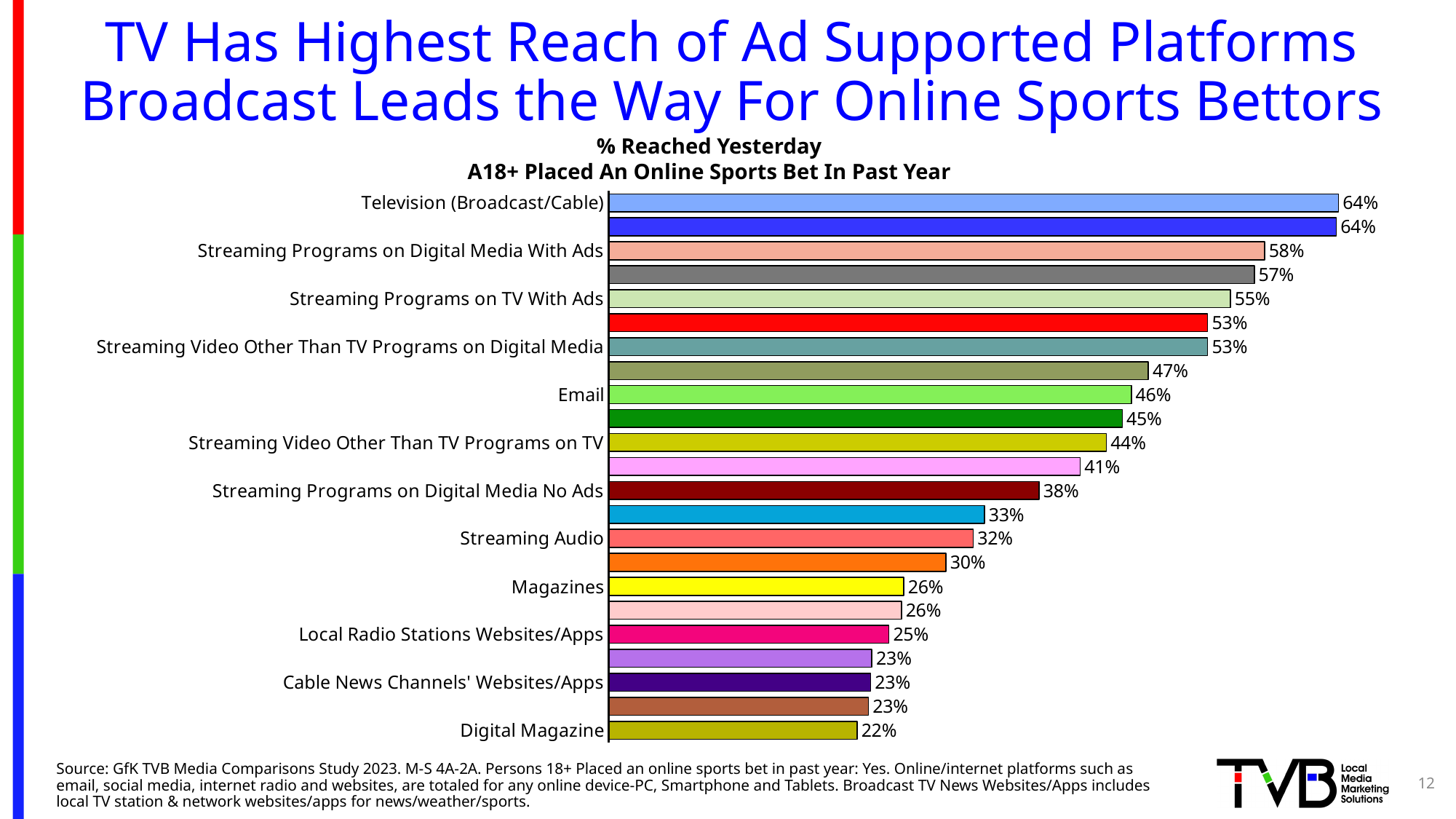
Which is larger, Streaming Video Other Than TV Programs on Digital Media or Streaming Video Other Than TV Programs on TV? Streaming Video Other Than TV Programs on Digital Media What kind of chart is shown on the slide? Bar chart What is the difference between Streaming Programs on TV With Ads and Streaming Programs on Digital Media No Ads? 17% What is the value for Email? 46% What is the value for Streaming Programs on Digital Media With Ads? 58% What is the difference between Television (Broadcast/Cable) and Magazines? 38% What is the value for Digital Magazine? 22% What is the value for Television (Broadcast/Cable)? 64% Which labeled category has the lowest value? Digital Magazine What is the chart's title? % Reached Yesterday A18+ Placed An Online Sports Bet In Past Year What is the value for Streaming Audio? 32% How many bars are plotted in the chart? 23